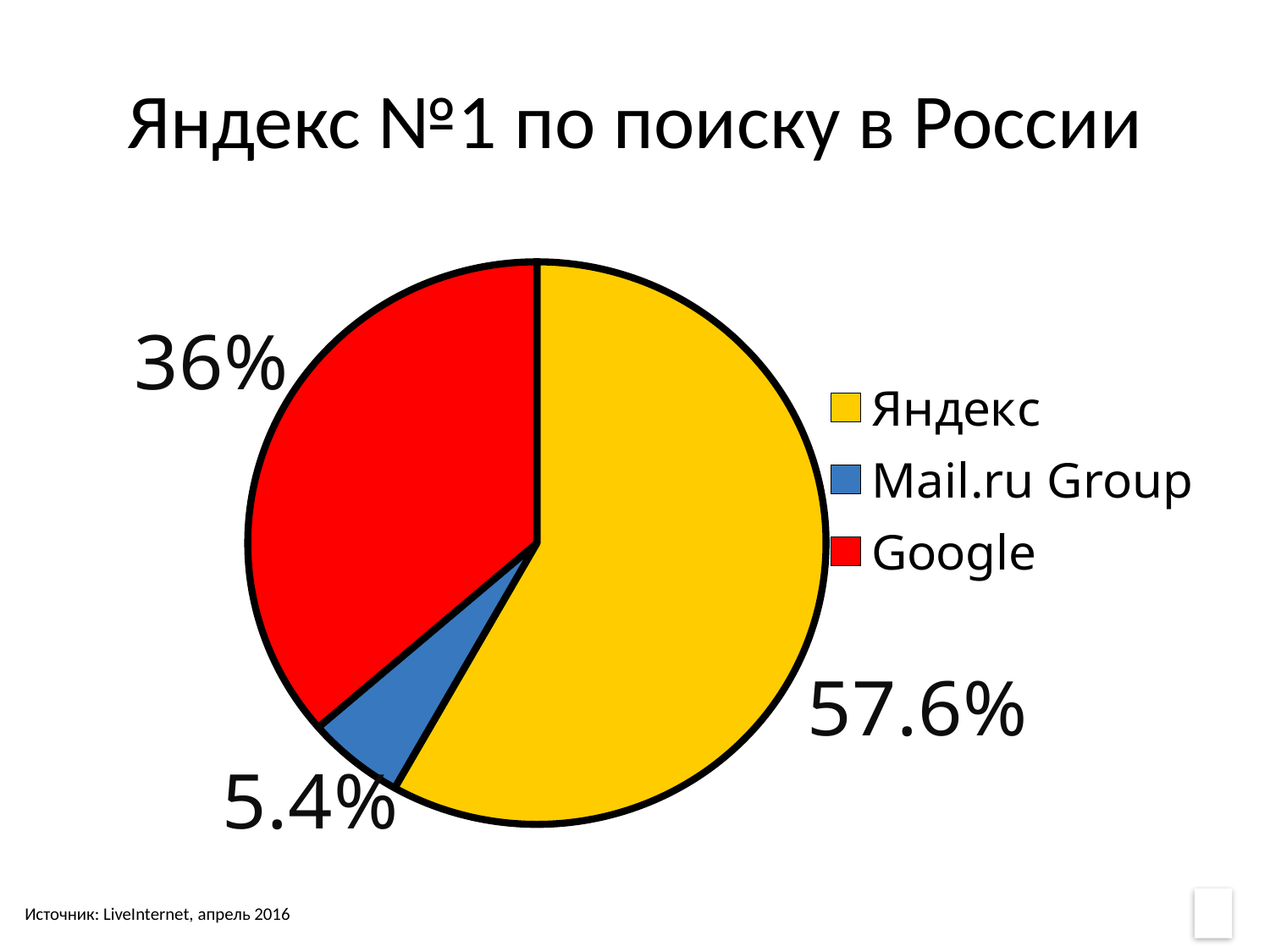
What is the value shown for Google? 36% Which is larger, the share of Google or the share of Mail.ru Group? Google What is the value shown for Mail.ru Group? 5.4% What kind of chart is shown on the slide? Pie chart How many categories are shown in the pie chart? 3 What is the title of the slide? Яндекс №1 по поиску в России Which category has the smallest slice of the pie? Mail.ru Group What is the difference between the shares of Google and Mail.ru Group? 30.6% What is the difference between the shares of Яндекс and Google? 21.6% Which category has the largest slice of the pie? Яндекс What share of the pie does Яндекс hold? 57.6% Which colour represents Google in the pie chart? Red